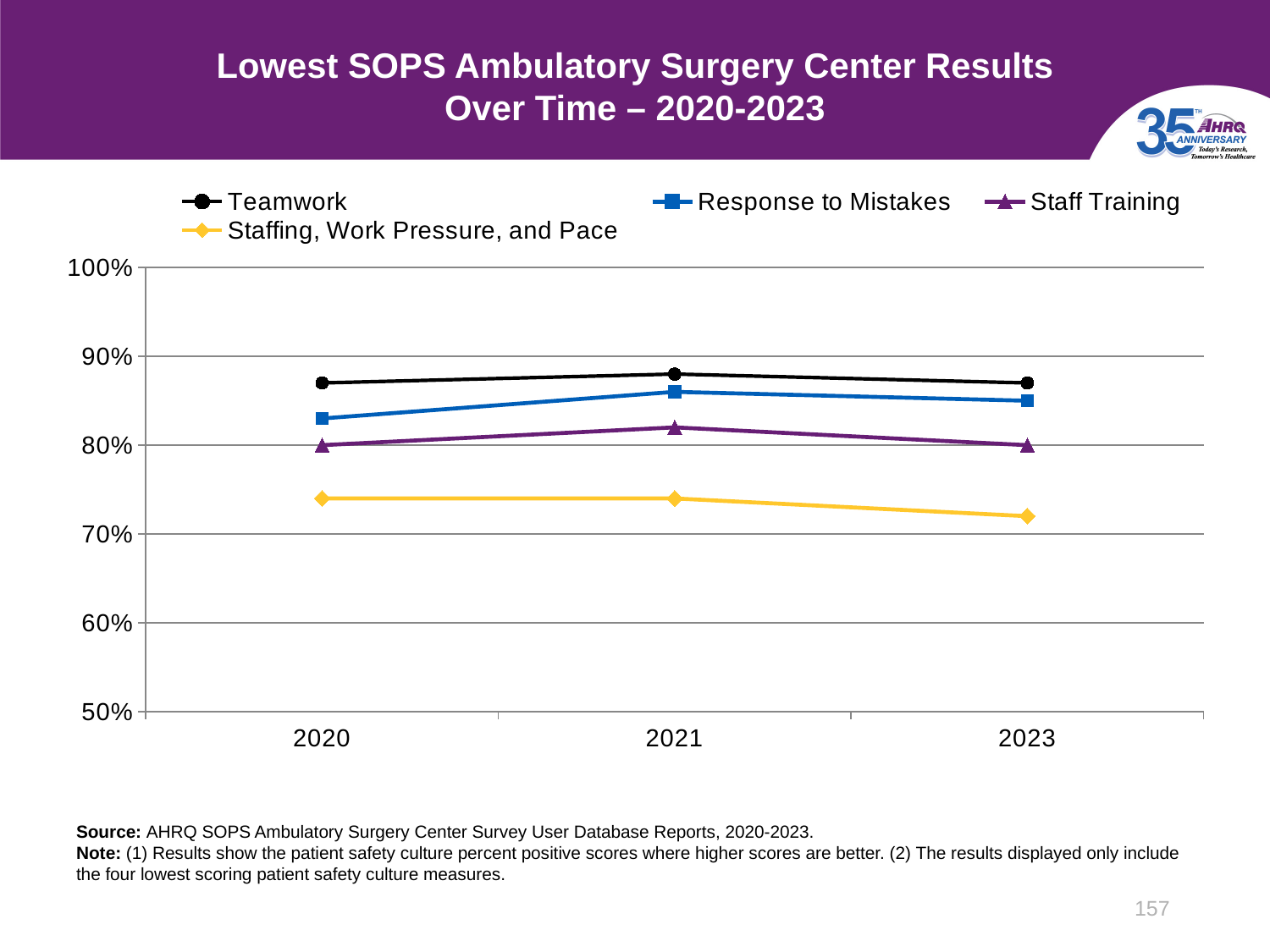
Is the value for Teamwork in 2021 greater or less than 80%? greater What kind of chart is shown on the slide? line chart Which series has the lowest values across all years? Staffing, Work Pressure, and Pace How many years are plotted along the x axis? 3 What is the value for Staff Training in 2023? 80% What is the title of the chart? Lowest SOPS Ambulatory Surgery Center Results Over Time – 2020-2023 Which series has the highest values across all years? Teamwork How many series does the legend list? 4 Is the value for Staffing, Work Pressure, and Pace in 2023 greater or less than 80%? less Does the Staffing, Work Pressure, and Pace line rise or fall from 2021 to 2023? fall Which is larger in 2023, Response to Mistakes or Staff Training? Response to Mistakes Is the value for Response to Mistakes in 2020 greater or less than 90%? less